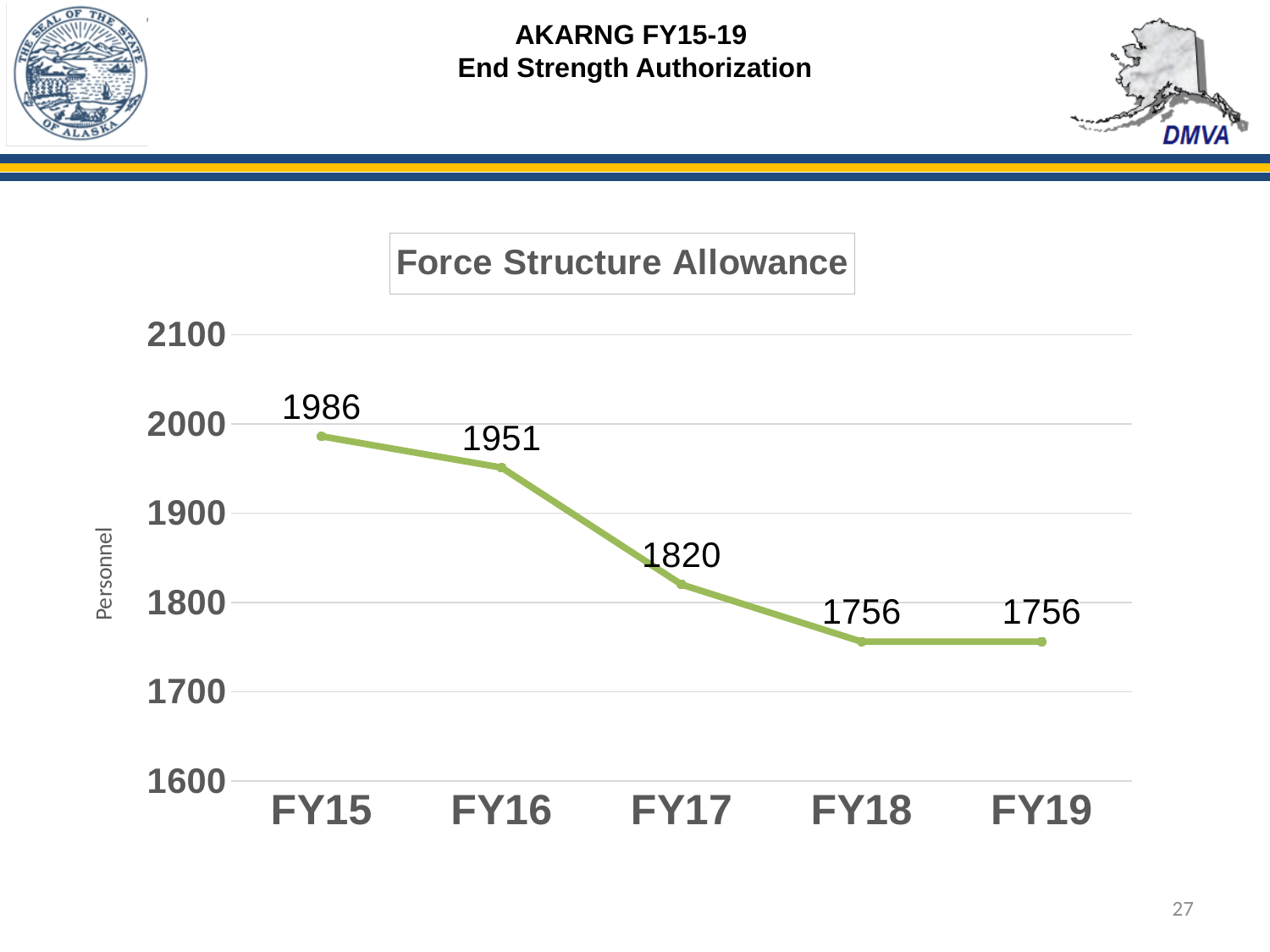
What is the difference between the FY15 and FY16 values? 35 Is the value for FY17 greater or less than 1900? less What kind of chart is shown on the slide? line chart Do the values rise or fall from FY15 to FY18? fall How many fiscal years are plotted on the chart? 5 What is the Force Structure Allowance value for FY17? 1820 What is the Force Structure Allowance value for FY19? 1756 What is the title of the chart? Force Structure Allowance Which is larger, the value for FY16 or the value for FY18? FY16 What is the Force Structure Allowance value for FY15? 1986 Which fiscal year has the highest Force Structure Allowance? FY15 What is the difference between the FY16 and FY17 values? 131